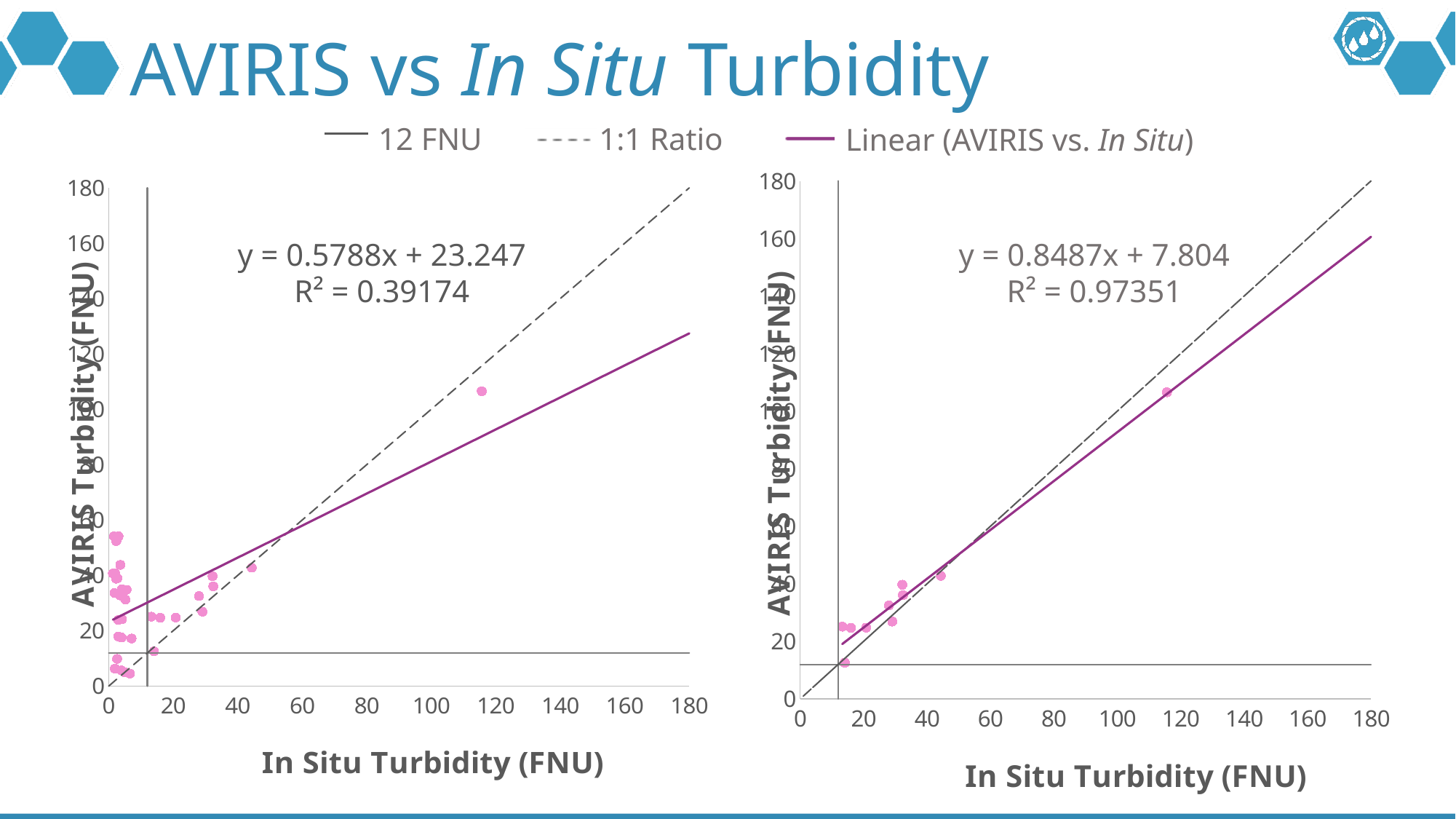
On the right chart, is the in situ turbidity of the rightmost data point greater or less than 100? greater What kind of chart is the right chart on the slide? scatter chart What is the x-axis label on the left chart? In Situ Turbidity (FNU) On the left chart, is the AVIRIS turbidity of the point with the highest in situ turbidity greater or less than 100? greater What is the maximum value shown on the y axis of the right chart? 180 On the right chart, what is the R² value shown for the linear fit? R² = 0.97351 On the right chart, what is the equation of the linear fit? y = 0.8487x + 7.804 On the left chart, what is the equation of the linear fit? y = 0.5788x + 23.247 On the left chart, what is the R² value shown for the linear fit? R² = 0.39174 How many entries does the shared legend at the top of the slide list? 3 Which chart has the higher R² value, the left chart or the right chart? the right chart What kind of chart is the left chart on the slide? scatter chart